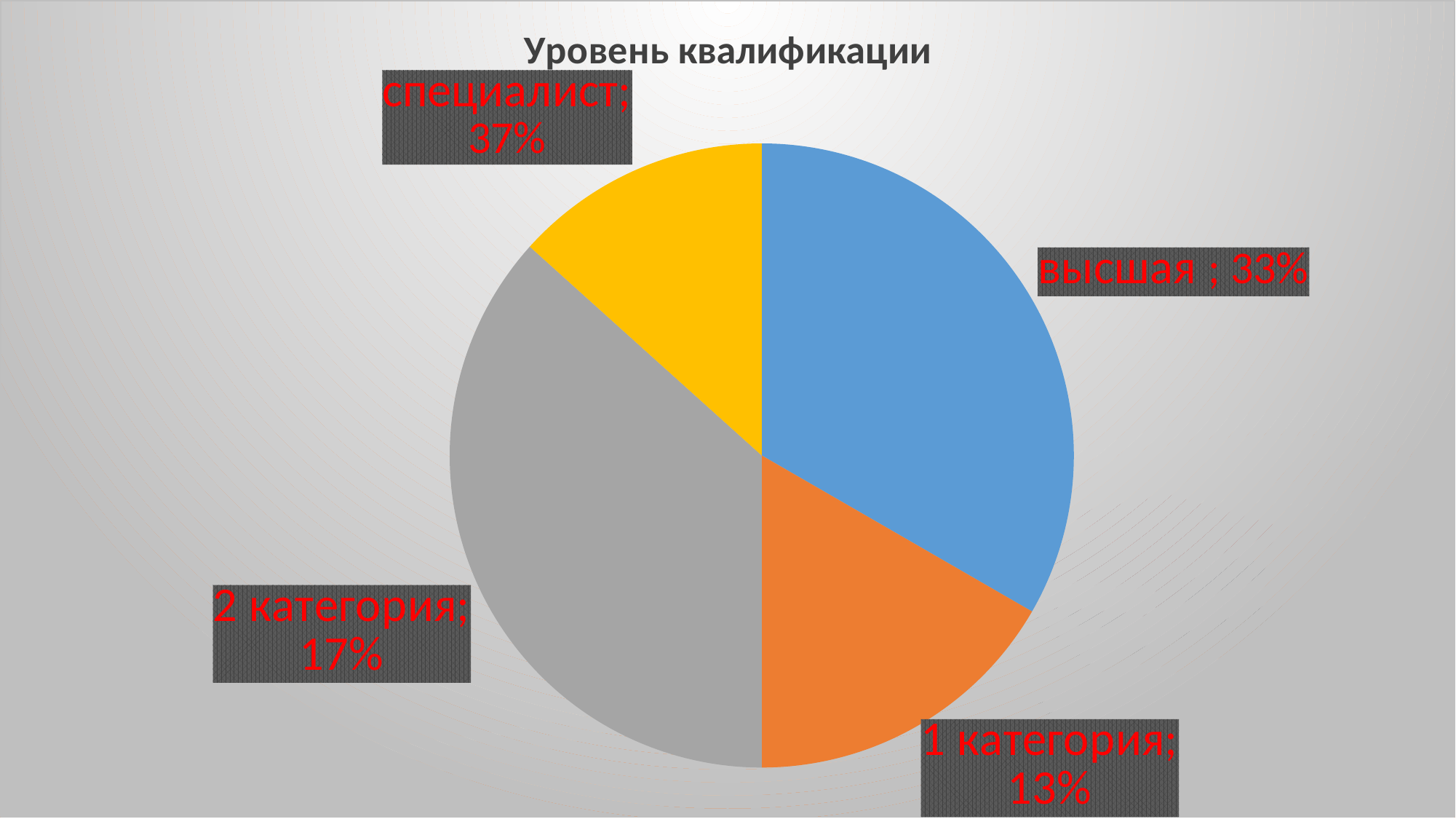
Which has the larger labelled share, "высшая" or "2 категория"? высшая What share of the pie is labelled "высшая"? 33% What is the difference between the labelled shares of "2 категория" and "1 категория"? 4% What share of the pie is labelled "2 категория"? 17% What kind of chart is shown on the slide? pie chart Which category has the smallest labelled share? 1 категория What is the difference between the labelled shares of "специалист" and "высшая"? 4% Which category has the largest labelled share? специалист How many slices does the pie chart have? 4 What share of the pie is labelled "специалист"? 37% What is the title of the chart? Уровень квалификации